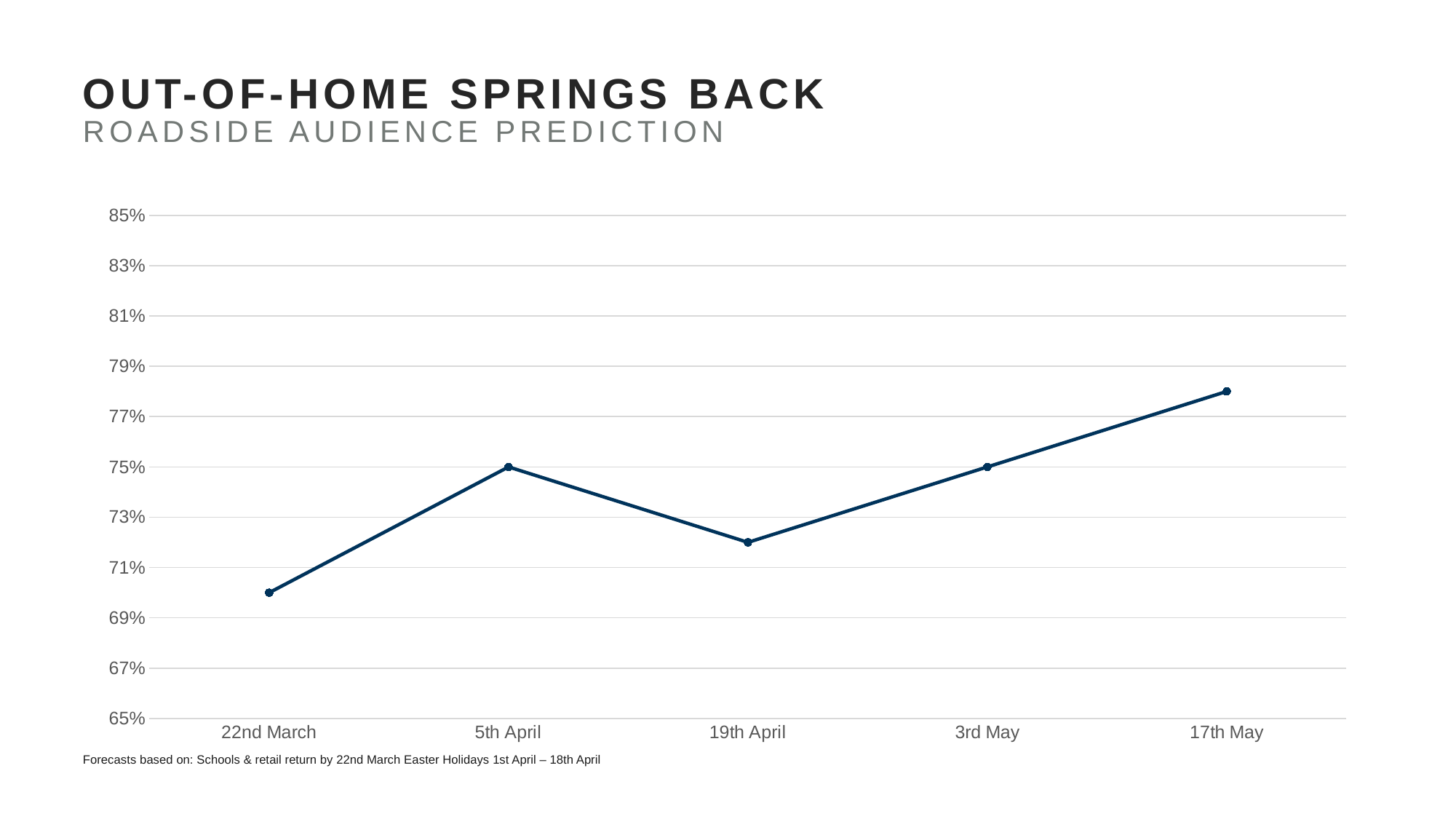
Is the value for 17th May greater or less than 77%? greater What is the subtitle of the chart slide? ROADSIDE AUDIENCE PREDICTION How many dates are plotted on the x axis of the chart? 5 Which date has the lowest value on the chart? 22nd March Does the value rise or fall between 3rd May and 17th May? rise Is the value for 19th April greater or less than 73%? less What is the predicted roadside audience value for 3rd May? 75% What kind of chart is shown on the slide? line chart Which is larger, the value for 5th April or the value for 19th April? 5th April What is the predicted roadside audience value for 5th April? 75% Is the value for 22nd March greater or less than 71%? less Which date has the highest value on the chart? 17th May